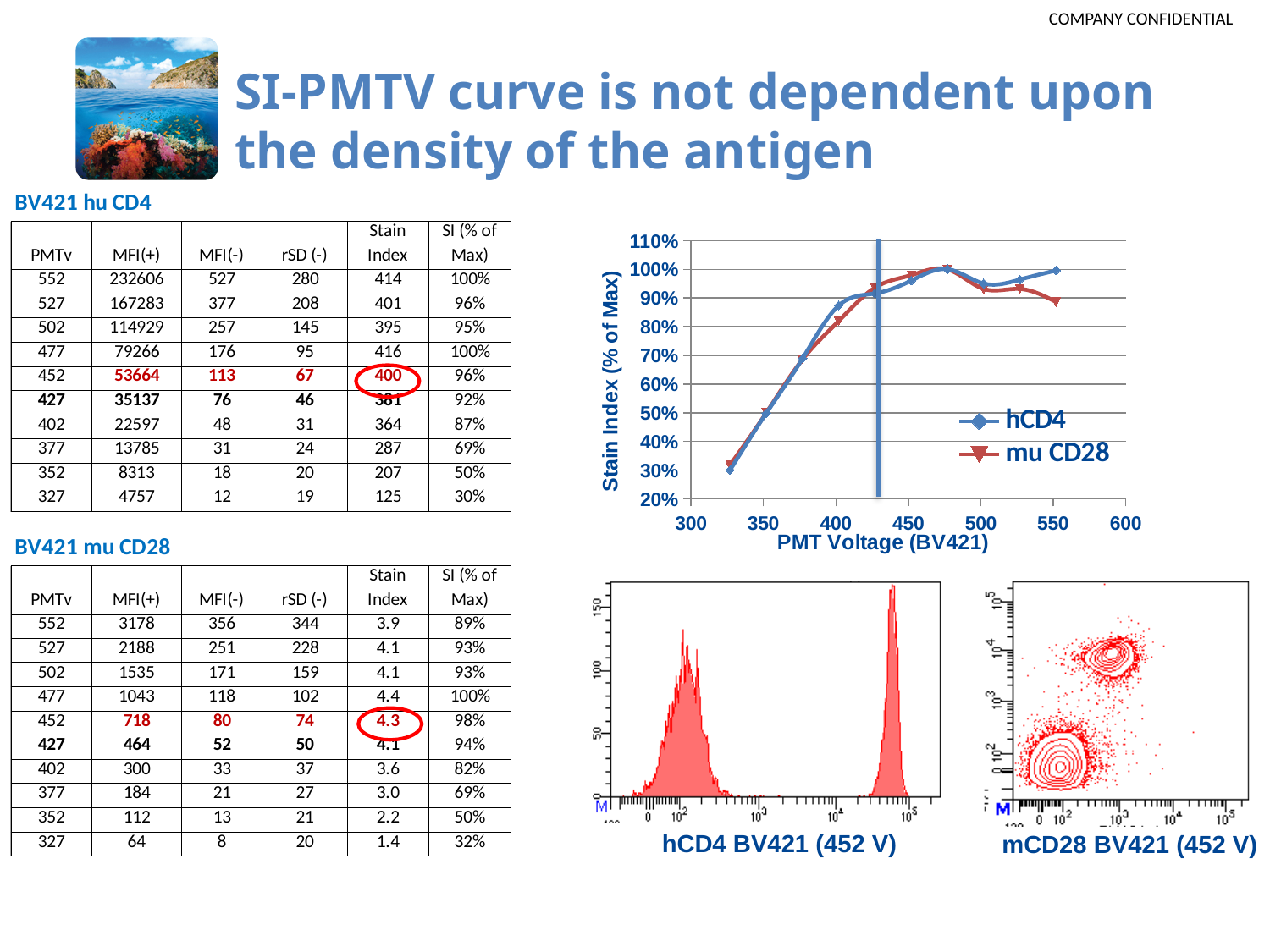
In the Stain Index versus PMT Voltage chart, which series has the higher value at 552 V, hCD4 or mu CD28? hCD4 In the Stain Index versus PMT Voltage chart, is the hCD4 value at 402 V greater or less than 80%? greater What is the x-axis title of the Stain Index versus PMT Voltage chart? PMT Voltage (BV421) How many series does the legend of the Stain Index versus PMT Voltage chart list? 2 In the Stain Index versus PMT Voltage chart, do the hCD4 values rise or fall as PMT voltage increases from 300 to 450? rise What kind of chart is the Stain Index versus PMT Voltage chart? line chart In the Stain Index versus PMT Voltage chart, is the mu CD28 value at 552 V greater or less than 100%? less In the Stain Index versus PMT Voltage chart, how many data points are plotted for the hCD4 series? 10 In the Stain Index versus PMT Voltage chart, is the hCD4 value at 327 V greater or less than 40%? less What is the y-axis title of the Stain Index versus PMT Voltage chart? Stain Index (% of Max)